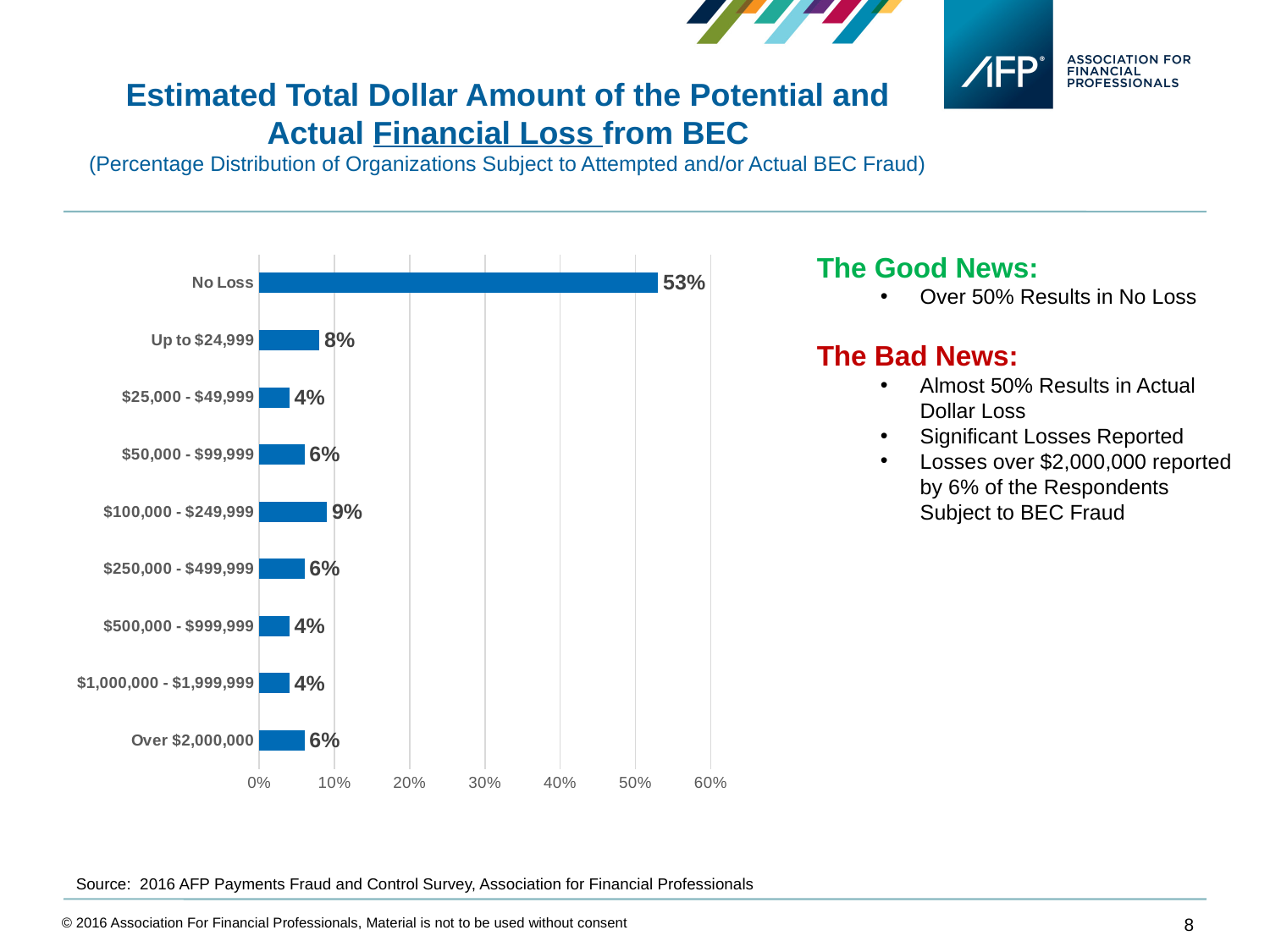
What is the value for the Up to $24,999 category? 8% What percentage of organizations reported No Loss? 53% Is the value for No Loss greater or less than 50%? greater What percentage of organizations reported losses Over $2,000,000? 6% What is the maximum value shown on the horizontal axis of the chart? 60% Which is larger, the value for Up to $24,999 or the value for $50,000 - $99,999? Up to $24,999 What is the difference between the No Loss value and the Up to $24,999 value? 45% Which category has the highest value? No Loss What kind of chart is shown on the slide? Bar chart How many categories are shown on the chart? 9 What is the difference between the $100,000 - $249,999 value and the $25,000 - $49,999 value? 5% What is the value for the $100,000 - $249,999 category? 9%